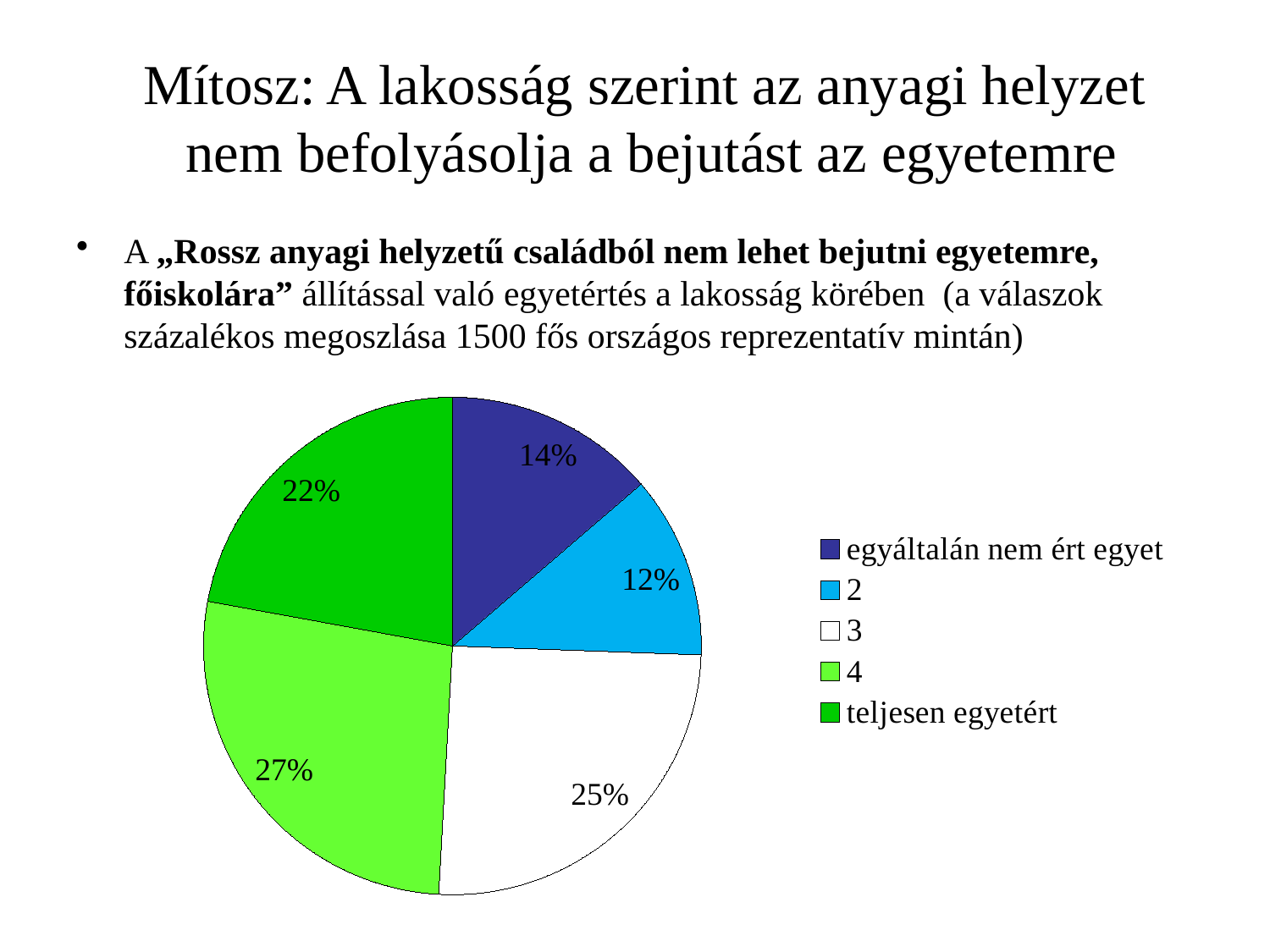
Which answer category has the largest slice of the pie? 4 What share of respondents gave the answer "2"? 12% How many slices does the pie chart have? 5 Which slice is larger: "teljesen egyetért" or "3"? 3 What share of respondents answered "egyáltalán nem ért egyet"? 14% What share of respondents answered "teljesen egyetért"? 22% How many entries does the legend list? 5 Which answer category has the smallest slice of the pie? 2 What share of respondents gave the answer "3"? 25% How many percentage points larger is the slice for "4" than the slice for "egyáltalán nem ért egyet"? 13 What colour is the slice for "3" in the pie chart? white What kind of chart is shown on the slide? pie chart